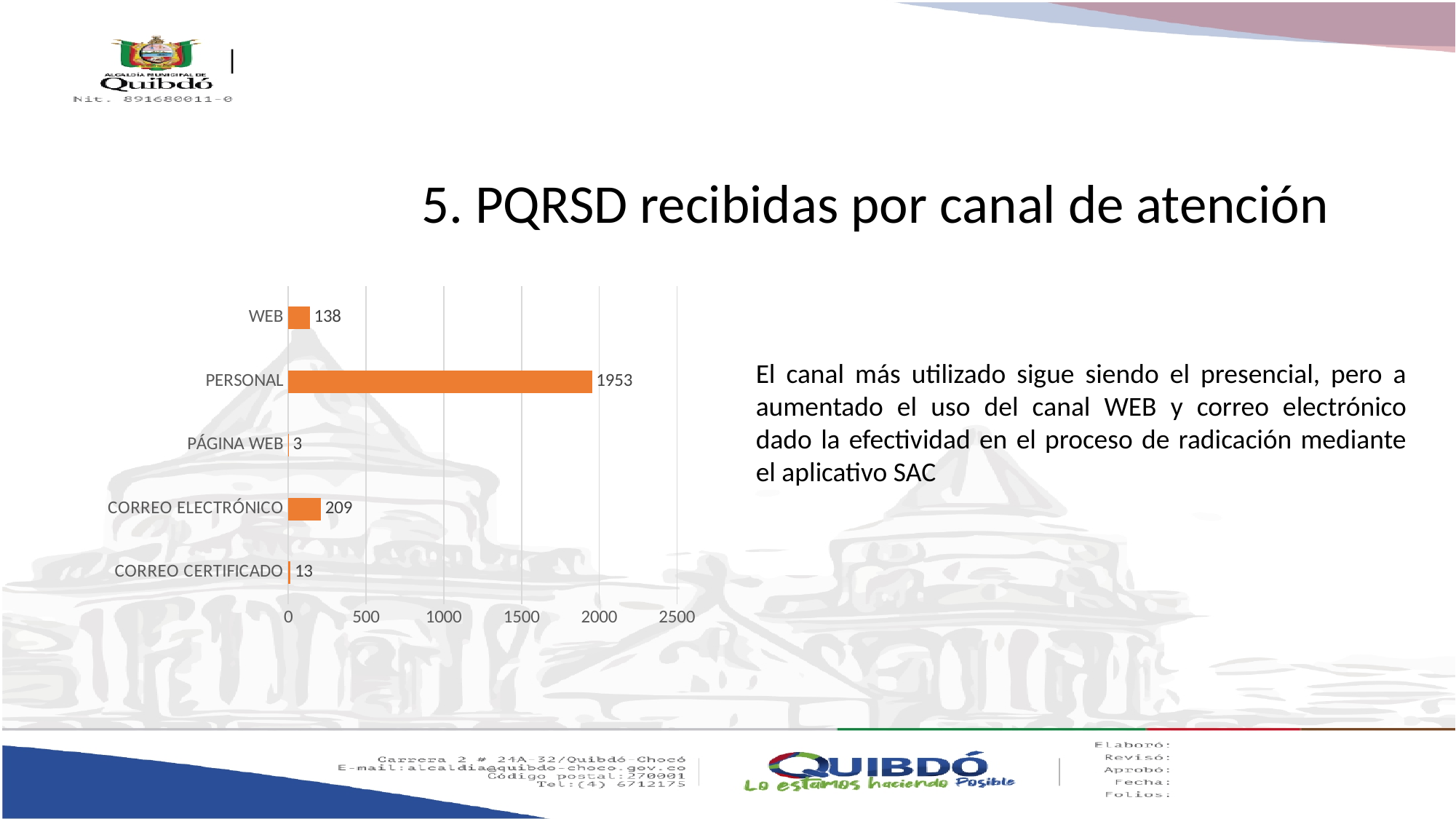
What is the value for CORREO CERTIFICADO? 13 Which category has the highest value? PERSONAL What is the value for PERSONAL? 1953 How many categories are shown in the chart? 5 Which category has the lowest value? PÁGINA WEB What is the value for CORREO ELECTRÓNICO? 209 Is the value for PERSONAL greater or less than 1500? greater What is the title of the slide containing the chart? 5. PQRSD recibidas por canal de atención Which is larger, the value for WEB or the value for CORREO ELECTRÓNICO? CORREO ELECTRÓNICO What is the value for WEB? 138 What is the difference between the values for PERSONAL and CORREO ELECTRÓNICO? 1744 What kind of chart is shown on the slide? bar chart